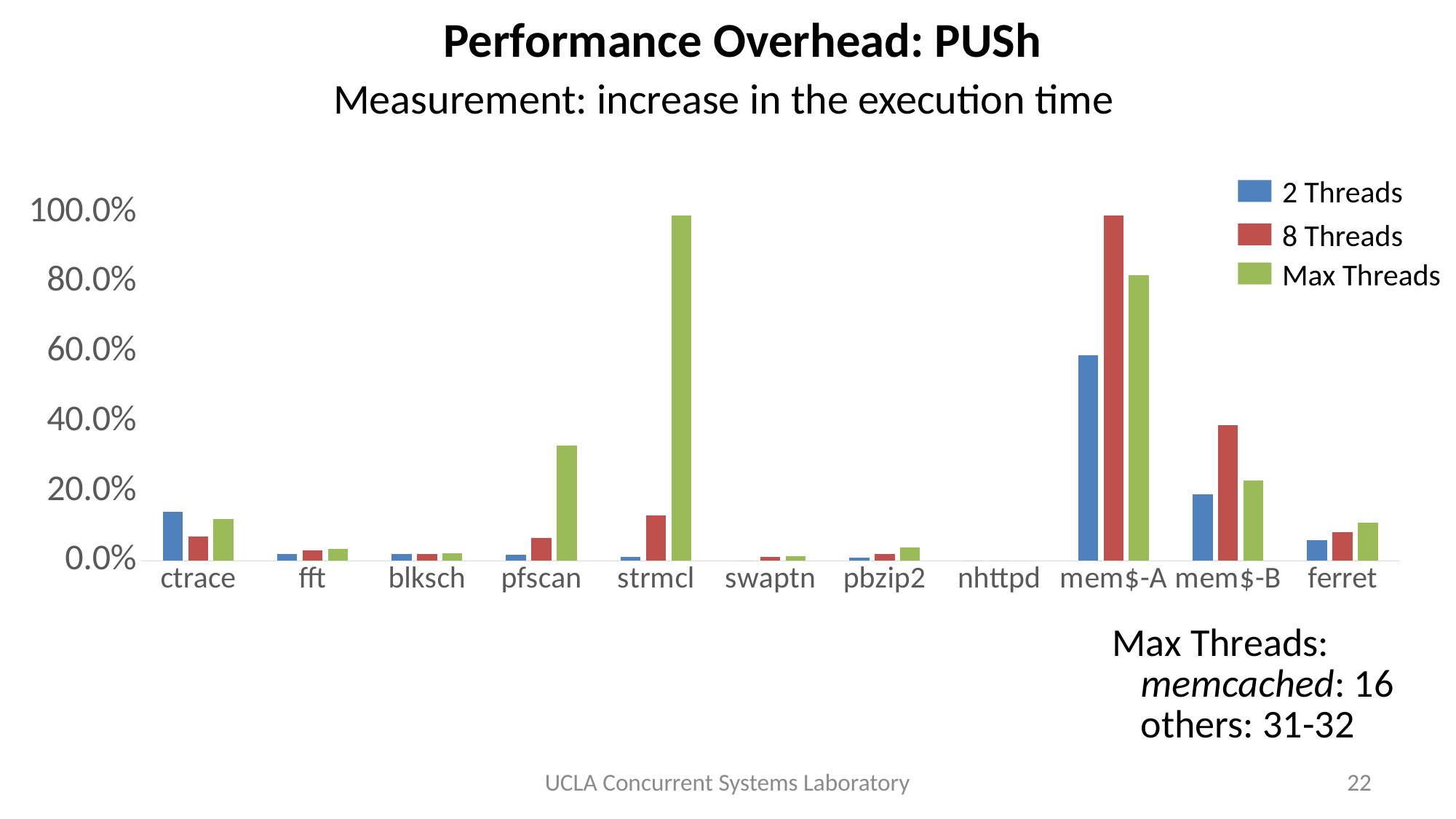
For ctrace, which is larger: the 2 Threads value or the 8 Threads value? 2 Threads Which category has the highest 2 Threads value? mem$-A Which category has the highest Max Threads value? strmcl What kind of chart is shown on the slide? bar chart Is the 2 Threads value for mem$-A greater or less than 40.0%? greater How many categories are shown on the x axis? 11 Which category has the highest 8 Threads value? mem$-A How many series does the legend list? 3 Is the Max Threads value for strmcl greater or less than 80.0%? greater Is the Max Threads value for pfscan greater or less than 20.0%? greater For mem$-B, which is larger: the 8 Threads value or the Max Threads value? 8 Threads What is the title of the chart? Performance Overhead: PUSh